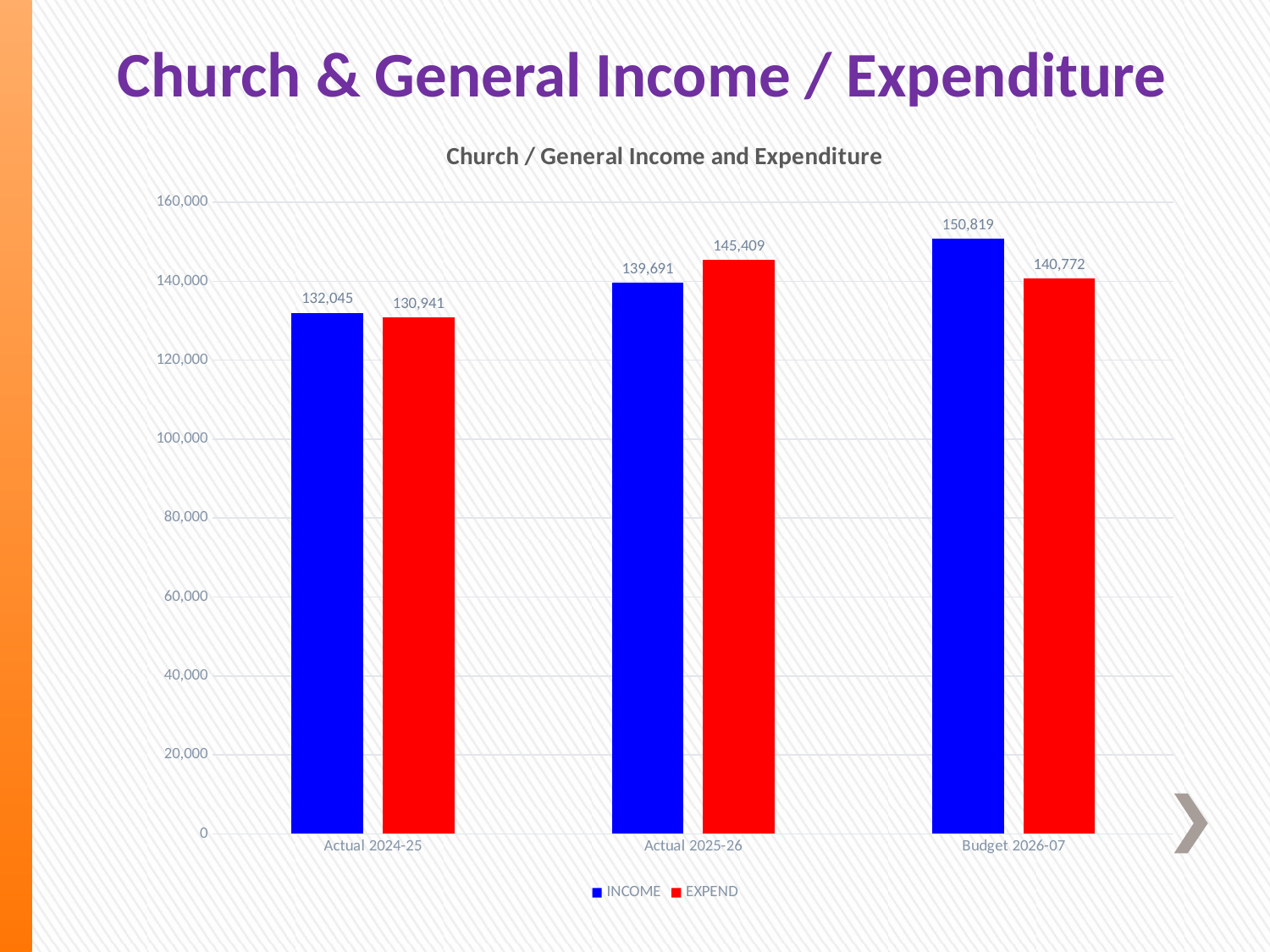
Which category has the highest INCOME value? Budget 2026-07 What kind of chart is shown on the slide? Bar chart What is the EXPEND value for Budget 2026-07? 140,772 What is the EXPEND value for Actual 2025-26? 145,409 How many categories are shown on the x axis? 3 What is the INCOME value for Budget 2026-07? 150,819 What is the difference between INCOME and EXPEND for Budget 2026-07? 10,047 Does the INCOME value rise or fall from Actual 2024-25 to Budget 2026-07? Rise What is the INCOME value for Actual 2024-25? 132,045 Which category has the lowest EXPEND value? Actual 2024-25 For Actual 2025-26, which is larger, INCOME or EXPEND? EXPEND How many series does the legend list? 2